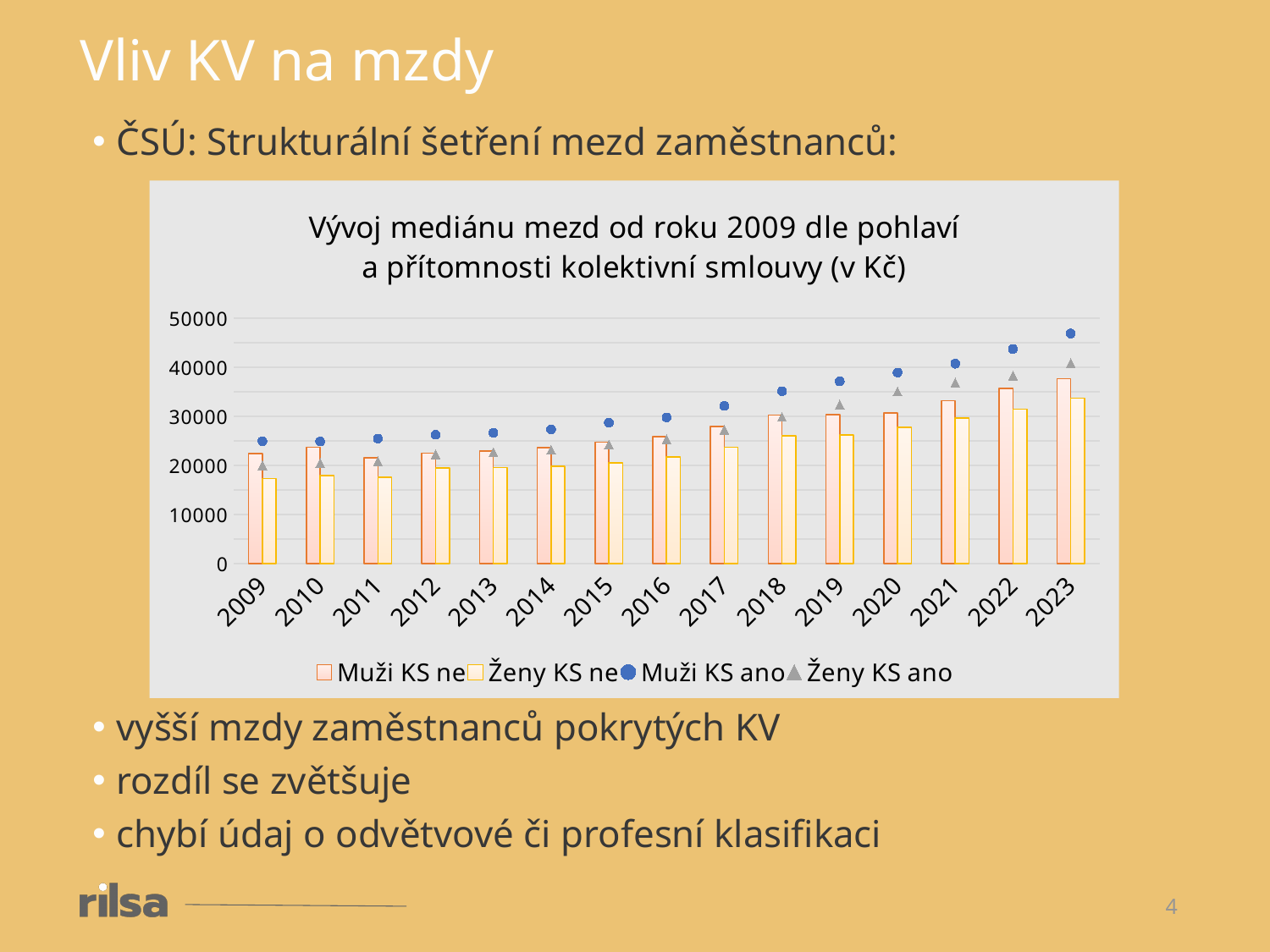
Is the value for Ženy KS ne in 2023 greater or less than 30000? greater How many series does the chart legend list? 4 Which series is shown with blue circle markers? Muži KS ano Is the value for Muži KS ano in 2009 greater or less than 20000? greater In 2023, which is larger: Muži KS ano or Ženy KS ne? Muži KS ano Do the values for Muži KS ano rise or fall from 2009 to 2023? rise In which year is the value for Muži KS ano the highest? 2023 What kind of chart is shown on the slide? bar chart with point markers Is the value for Muži KS ano in 2023 greater or less than 40000? greater How many years are shown on the x axis of the chart? 15 What is the title of the chart? Vývoj mediánu mezd od roku 2009 dle pohlaví a přítomnosti kolektivní smlouvy (v Kč)